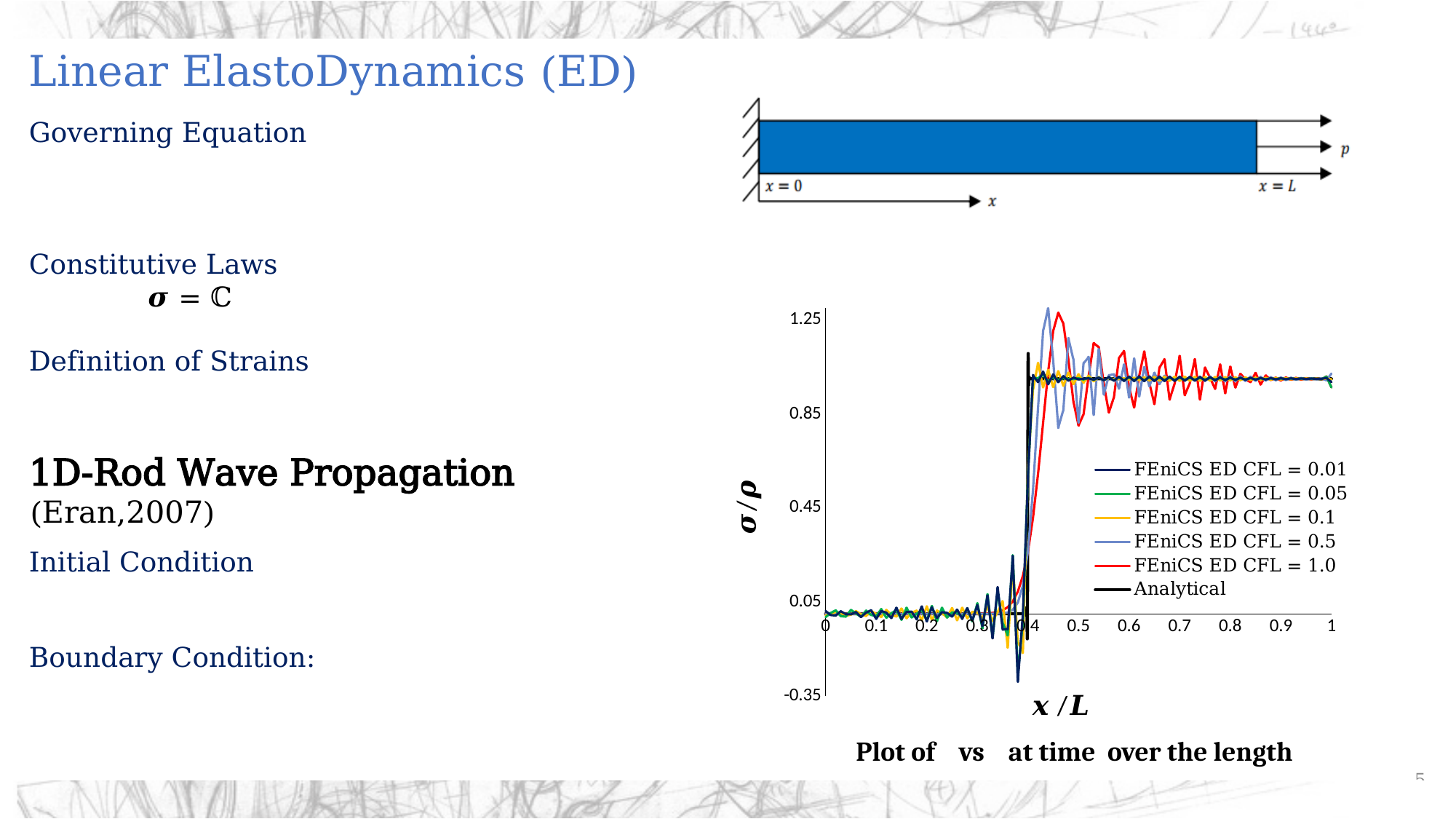
What kind of chart is shown on the slide? line chart What is the label of the y axis of the chart? σ / ρ Is the peak value of the FEniCS ED CFL = 1.0 series greater or less than 0.85? greater What is the label of the x axis of the chart? x / L How many series does the chart legend list? 6 How many tick labels are shown on the x axis of the chart? 11 Is the Analytical value at x/L = 0.2 greater or less than 0.45? less Is the Analytical value at x/L = 0.8 greater or less than 0.45? greater Overall, do the plotted values rise or fall as x/L increases from 0 to 1? rise Which series reaches the lowest value on the chart? FEniCS ED CFL = 0.01